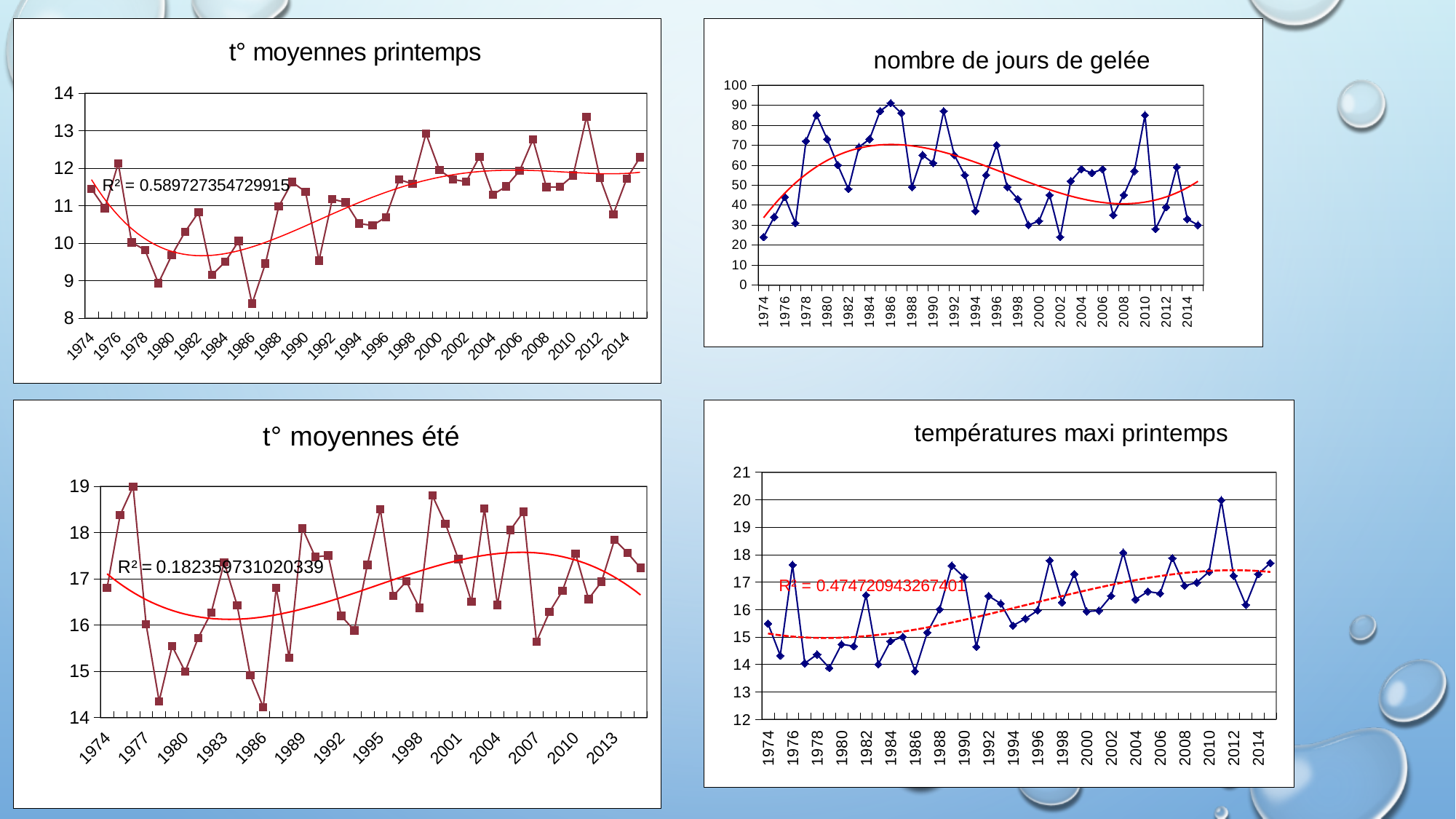
In the "t° moyennes été" chart, is the value for 1976 greater or less than 18? greater In the "t° moyennes printemps" chart, which year has the lowest value? 1986 In the "températures maxi printemps" chart, which year has the highest value? 2011 In the "nombre de jours de gelée" chart, is the value for 1986 greater or less than 80? greater In the "t° moyennes printemps" chart, which year has the highest value? 2011 What R² value is printed on the "t° moyennes printemps" chart? R² = 0.589727354729915 What kind of chart is "t° moyennes printemps"? line chart In the "nombre de jours de gelée" chart, is the value for 2002 greater or less than 30? less In the "températures maxi printemps" chart, do the values generally rise or fall from 1974 to 2015? rise In the "t° moyennes été" chart, which year has the highest value? 1976